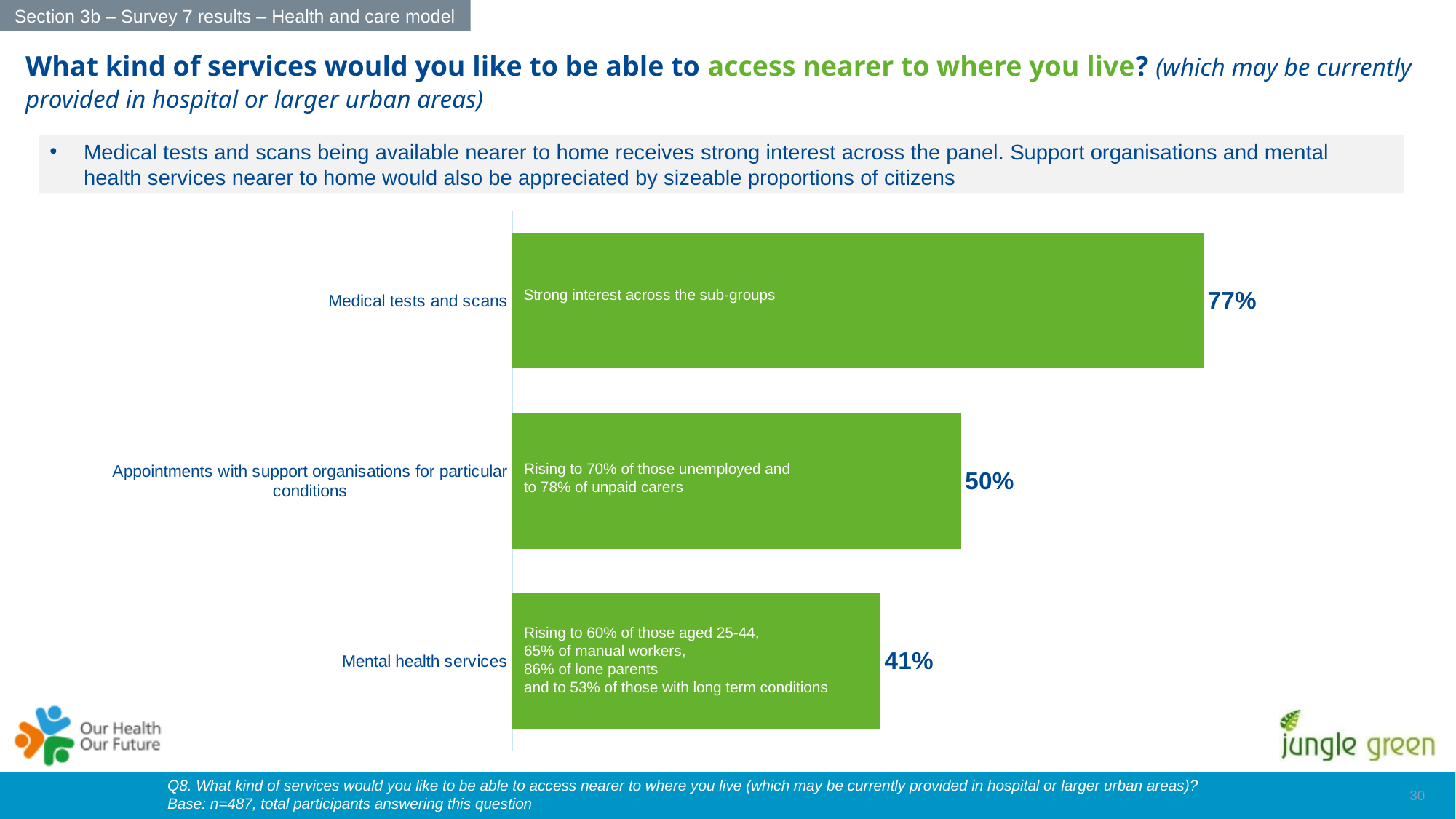
What is the value shown for appointments with support organisations for particular conditions? 50% How many service categories are shown on the chart? 3 What colour are the bars on the chart? Green What percentage of respondents would like medical tests and scans to be accessible nearer to where they live? 77% What kind of chart is used on this slide? Bar chart What is the difference in percentage points between appointments with support organisations and mental health services? 9 Which is larger: the value for medical tests and scans or the value for appointments with support organisations for particular conditions? Medical tests and scans Which service has the highest percentage of respondents wanting it nearer to where they live? Medical tests and scans What percentage is shown for mental health services? 41% Which service has the lowest percentage on the chart? Mental health services According to the annotation on the bar, to what percentage does interest in appointments with support organisations rise among unpaid carers? 78% What is the difference in percentage points between medical tests and scans and mental health services? 36